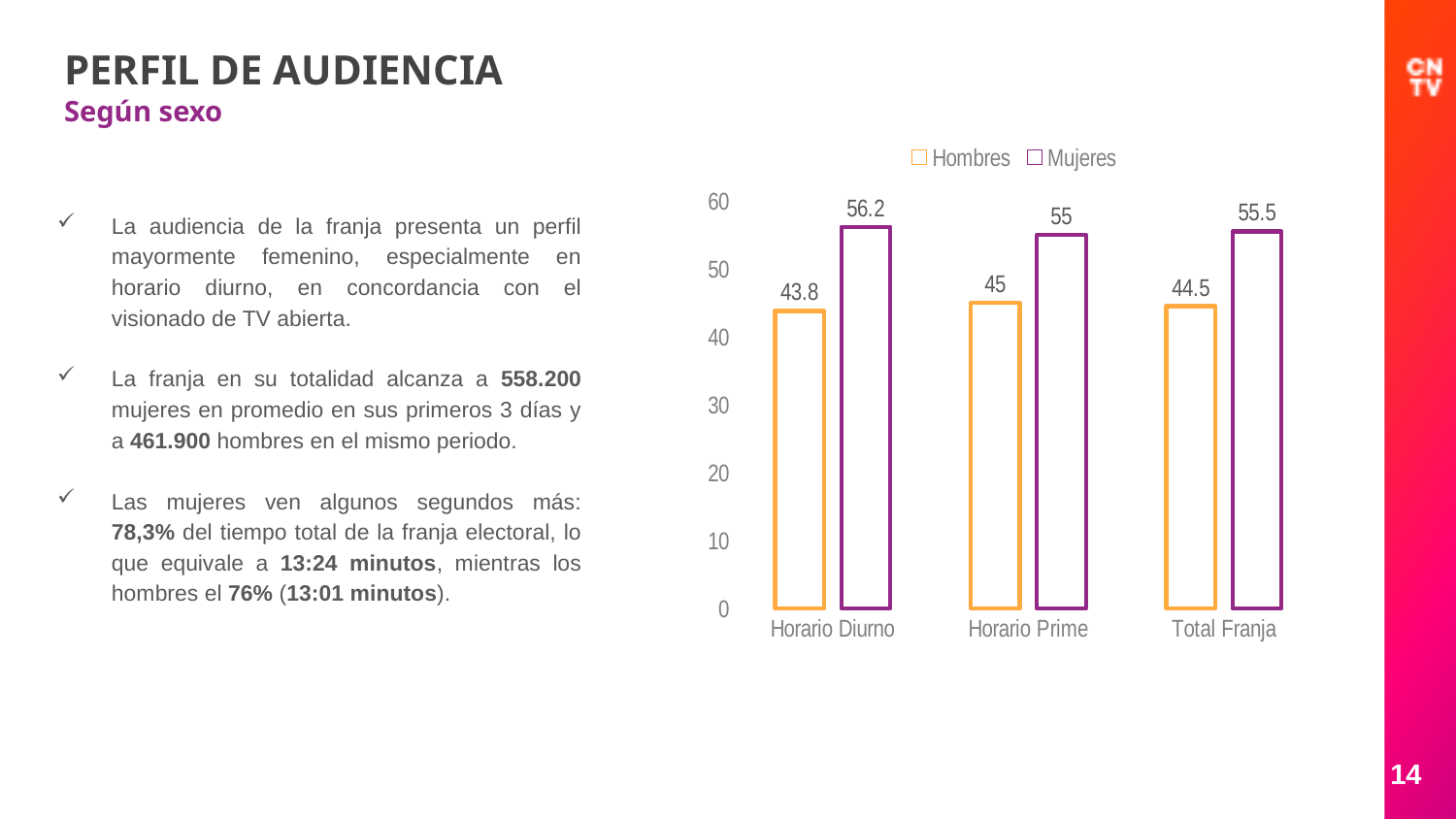
What is the difference between Mujeres and Hombres in Horario Prime? 10 What is the value for Mujeres in Total Franja? 55.5 What is the value for Hombres in Horario Prime? 45 What kind of chart is shown on the slide? Bar chart How many series does the legend list? 2 Which is larger in Total Franja, Hombres or Mujeres? Mujeres What is the difference between Mujeres and Hombres in Horario Diurno? 12.4 How many categories are shown on the x axis? 3 Which category has the highest value for Mujeres? Horario Diurno What is the value for Mujeres in Horario Diurno? 56.2 What is the value for Hombres in Total Franja? 44.5 Which category has the lowest value for Hombres? Horario Diurno